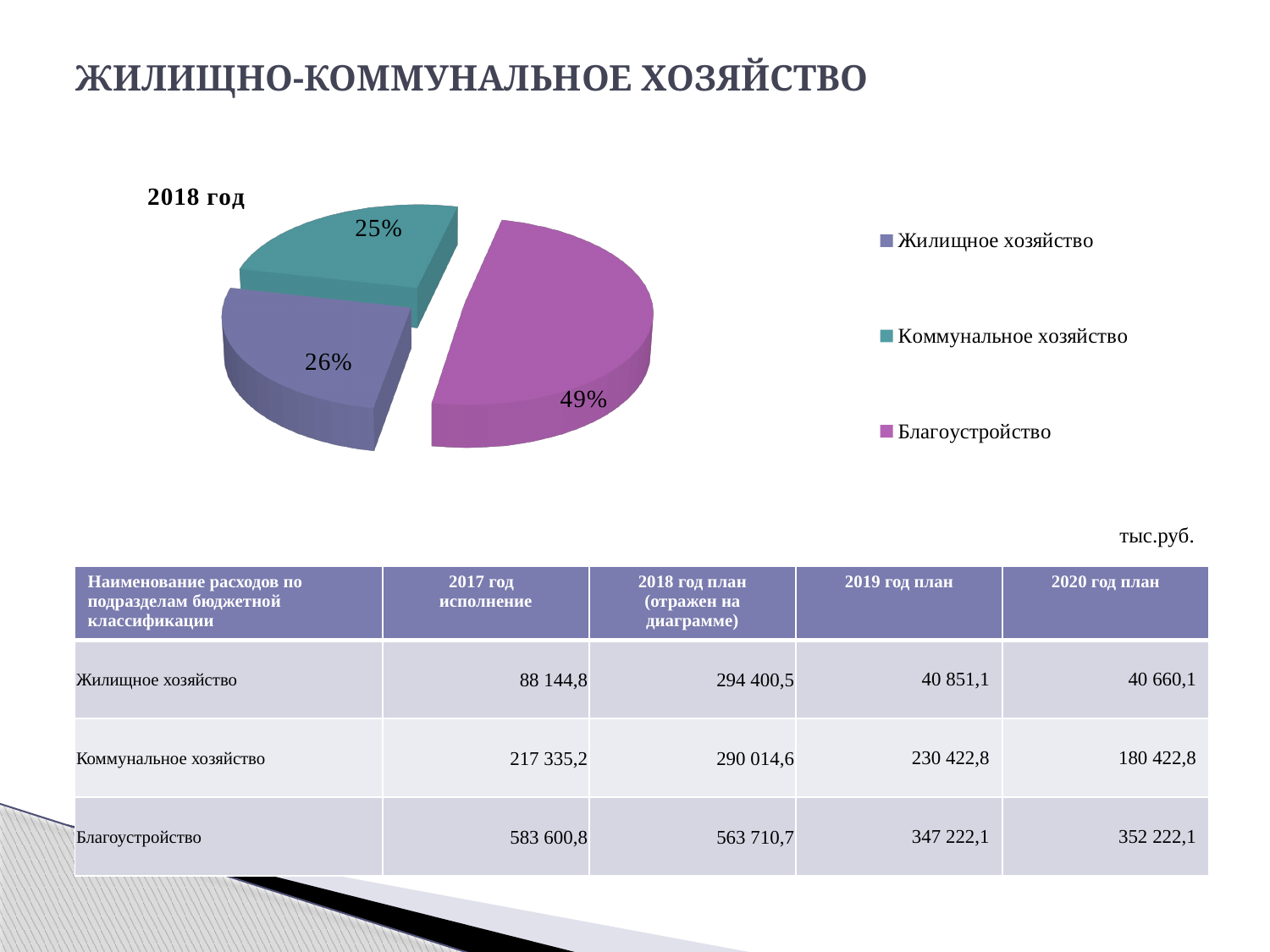
What kind of chart is shown on the slide? Pie chart How many slices does the pie chart have? 3 Which category has the largest slice in the pie chart? Благоустройство By how many percentage points does the Благоустройство slice exceed the Жилищное хозяйство slice? 23 percentage points Which slice is larger in the pie chart: Благоустройство or Коммунальное хозяйство? Благоустройство What colour is the Коммунальное хозяйство slice in the pie chart? Teal What share of the pie chart does Жилищное хозяйство represent? 26% How many entries does the legend of the pie chart list? 3 Which category has the smallest slice in the pie chart? Коммунальное хозяйство What is the title of the pie chart? 2018 год What share of the pie chart does Коммунальное хозяйство represent? 25% What share of the pie chart does Благоустройство represent? 49%